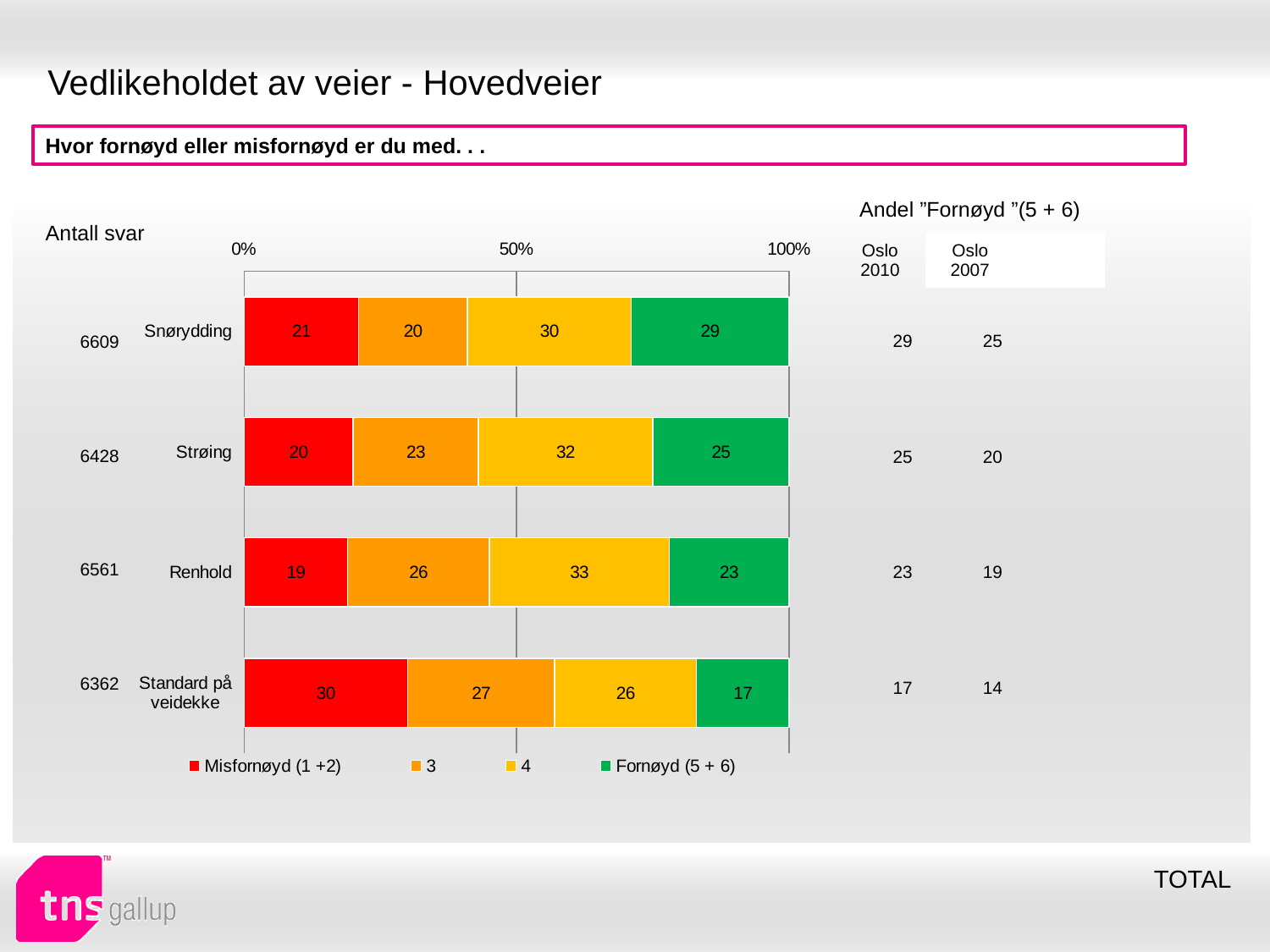
How many series does the legend list? 4 Which is larger: the "4" segment for Strøing or the "4" segment for Snørydding? Strøing What is the value of the "3" segment for Strøing? 23 What is the value of the "4" segment for Renhold? 33 Which category has the highest "Fornøyd (5 + 6)" value? Snørydding What is the value of the "Fornøyd (5 + 6)" segment for Standard på veidekke? 17 What is the total of the stacked bar for Strøing? 100 How many categories are shown in the chart? 4 What kind of chart is shown on the slide? Stacked bar chart Which category has the lowest "Fornøyd (5 + 6)" value? Standard på veidekke What is the value of the "Misfornøyd (1 +2)" segment for Snørydding? 21 What is the difference between the "Misfornøyd (1 +2)" values for Standard på veidekke and Renhold? 11